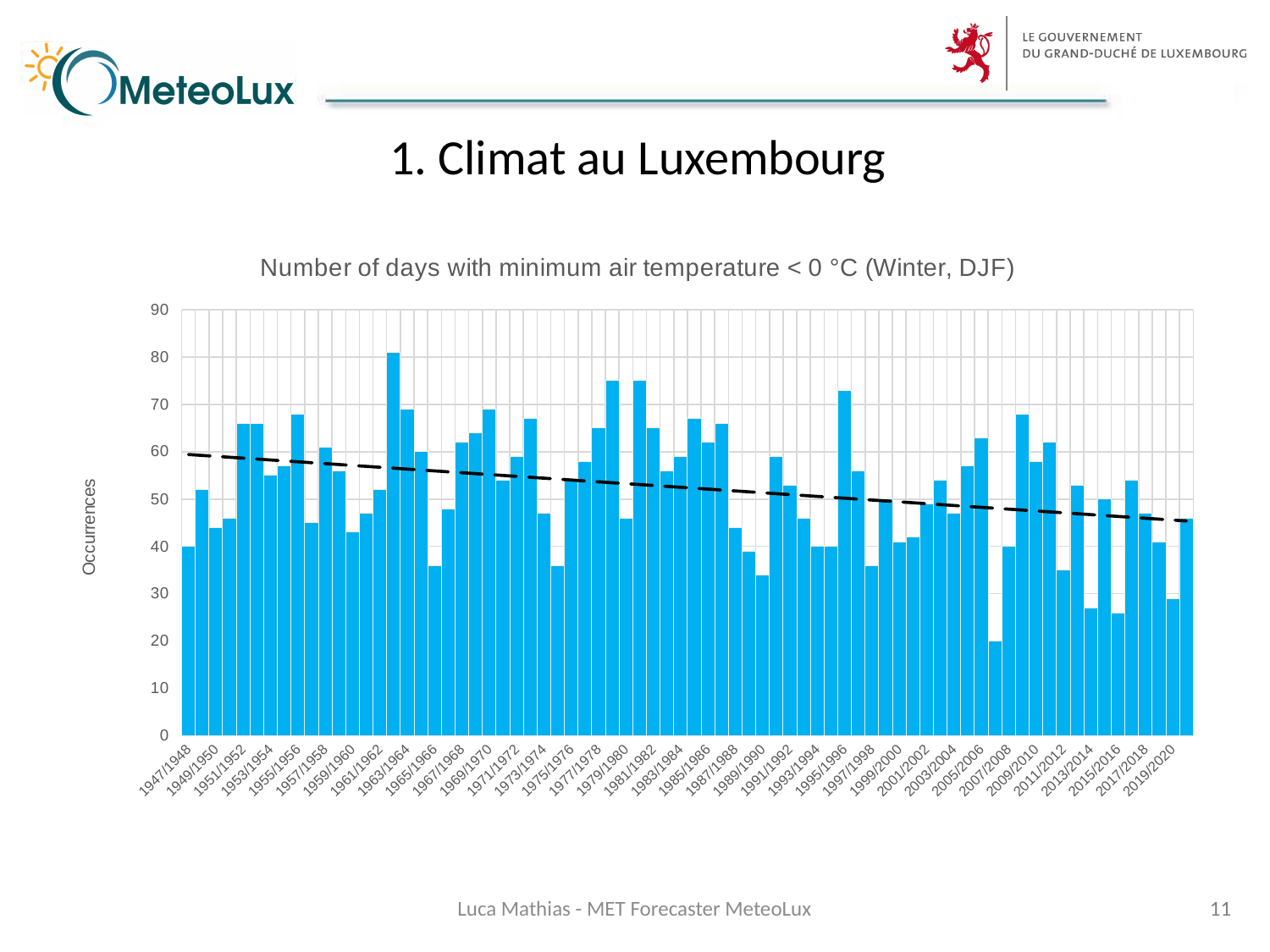
Is the highest bar on the chart greater or less than 70? greater What is the title of the chart? Number of days with minimum air temperature < 0 °C (Winter, DJF) What kind of chart is shown on the slide? bar chart What is the highest value shown on the vertical axis? 90 What is the label on the vertical axis of the chart? Occurrences Does the dashed trend line rise or fall from left to right across the chart? fall Is the value for 1947/1948 greater or less than 50? less Is the lowest bar on the chart greater or less than 30? less